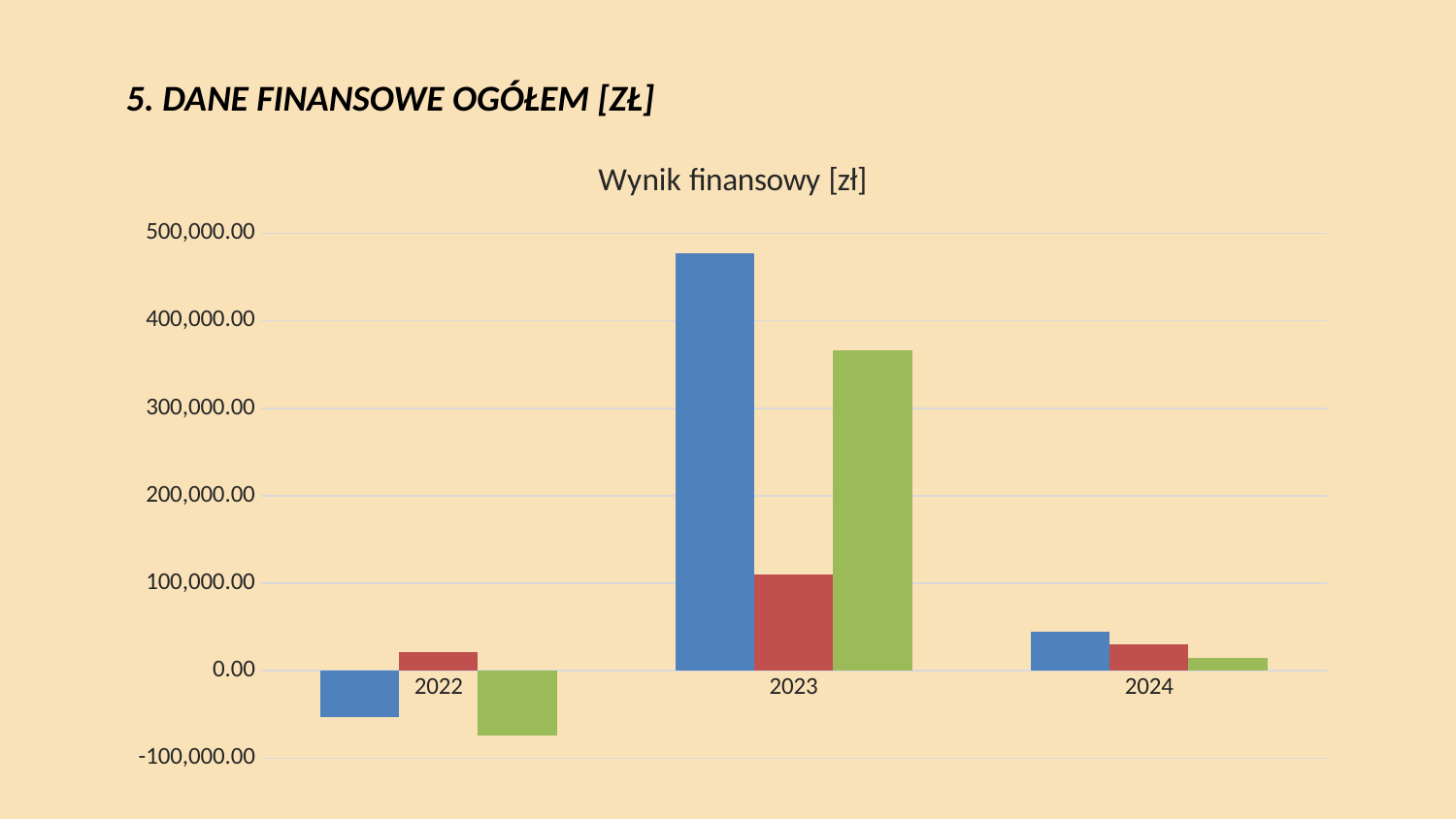
Is the value of the red bar for 2023 greater or less than 200,000.00? less What is the title of the chart? Wynik finansowy [zł] Is the value of the blue bar for 2022 greater or less than 0.00? less For 2023, which is larger: the blue bar or the green bar? the blue bar How many bars are plotted for each year in the chart? 3 Is the value of the green bar for 2022 greater or less than -100,000.00? greater Which year has the highest blue bar in the chart? 2023 Which year has the lowest green bar in the chart? 2022 How many years are shown on the x axis of the chart? 3 What type of chart is shown on the slide? bar chart